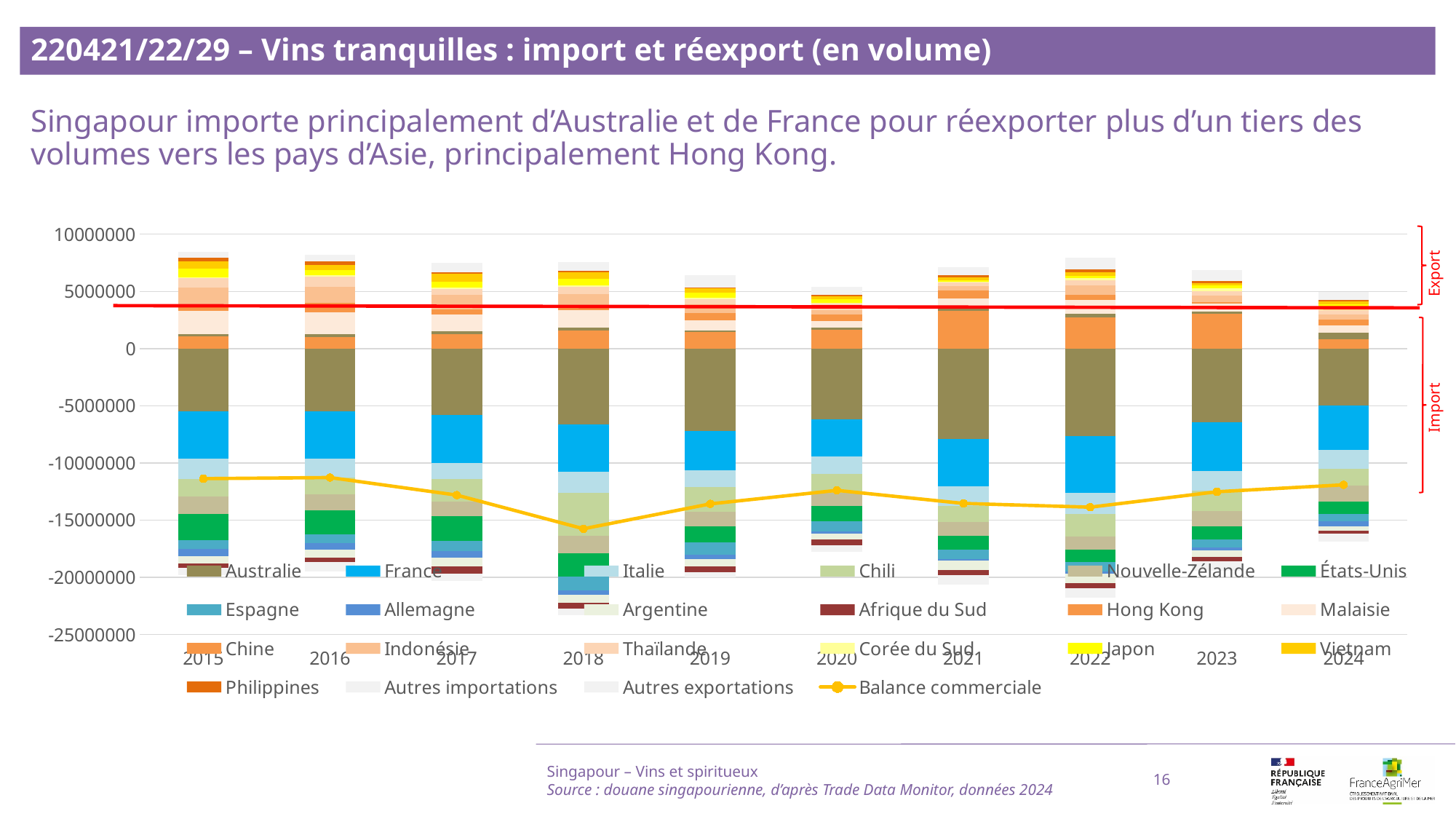
Does the import stack (negative bars) for 2018 extend below -20000000? Yes Which series is plotted as a line rather than as bars? Balance commerciale In which year is the Balance commerciale line at its lowest point? 2018 Does the Balance commerciale line rise or fall from 2018 to 2024? rise Which year has the larger total export stack (positive bars), 2015 or 2024? 2015 How many years are shown on the x axis of the chart? 10 Is the Balance commerciale value for 2015 greater or less than -15000000? greater What kind of chart is shown on the slide? Stacked bar chart with a line Is the Balance commerciale value for 2018 greater or less than -15000000? less What is the first year shown on the x axis? 2015 How many series does the chart legend list? 22